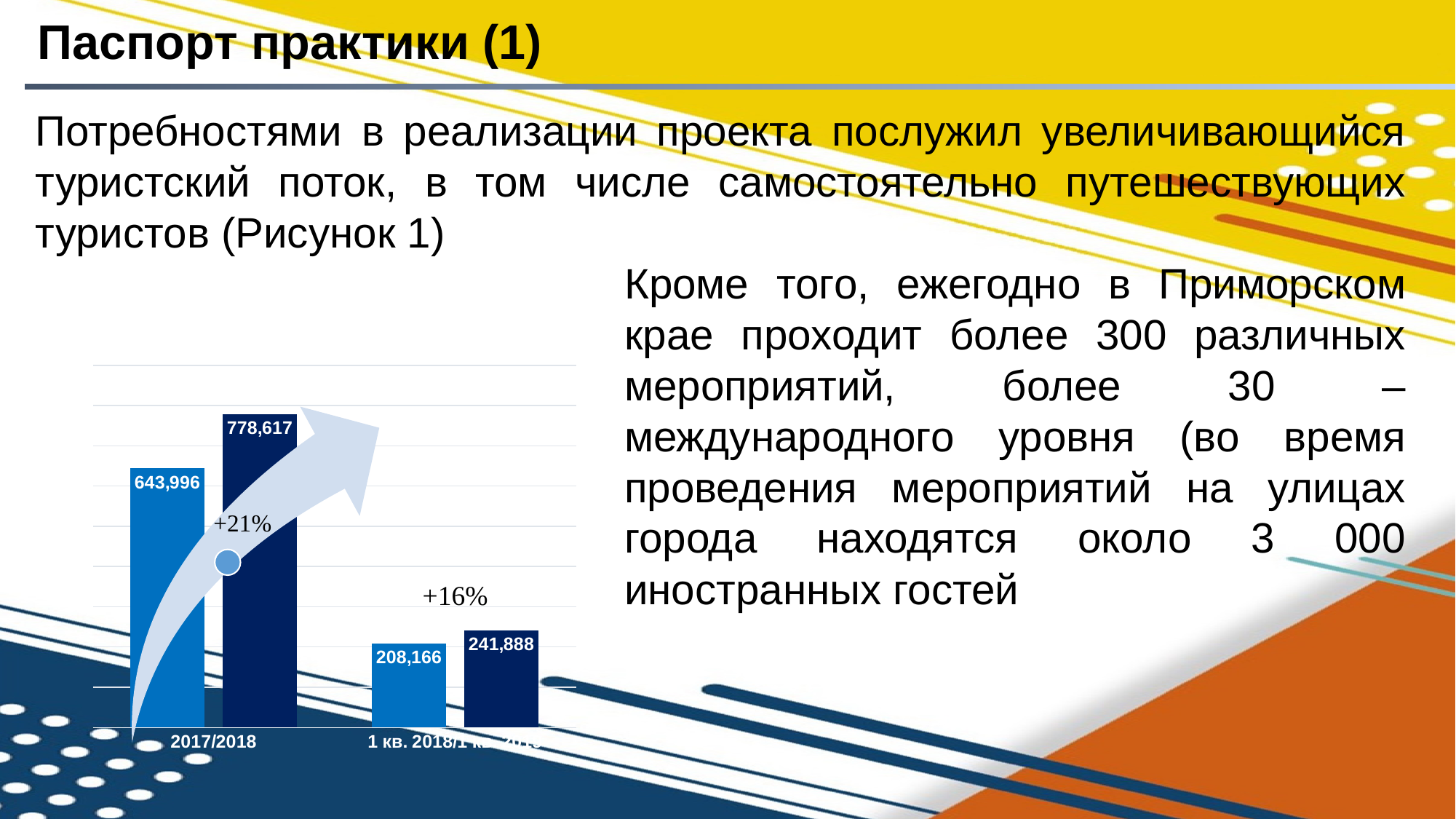
What percentage change is annotated above the 2017/2018 group of bars? +21% Which is larger: the light blue bar for 2017/2018 or the dark blue bar in the right-hand group? the light blue bar for 2017/2018 (643,996) What kind of chart is shown on the slide? bar chart Which bar has the highest value in the chart? the dark blue bar for 2017/2018 (778,617) What is the value of the light blue bar for 2017/2018? 643,996 What is the value of the light blue bar in the right-hand group (1 кв. 2018/1 кв. 2019)? 208,166 What is the difference between the dark blue and light blue bars in the right-hand group? 33,722 What is the value of the dark blue bar in the right-hand group (1 кв. 2018/1 кв. 2019)? 241,888 What is the difference between the dark blue and light blue bars for 2017/2018? 134,621 Which bar has the lowest value in the chart? the light blue bar in the right-hand group (208,166) How many bars are plotted in the chart? 4 What is the value of the dark blue bar for 2017/2018? 778,617